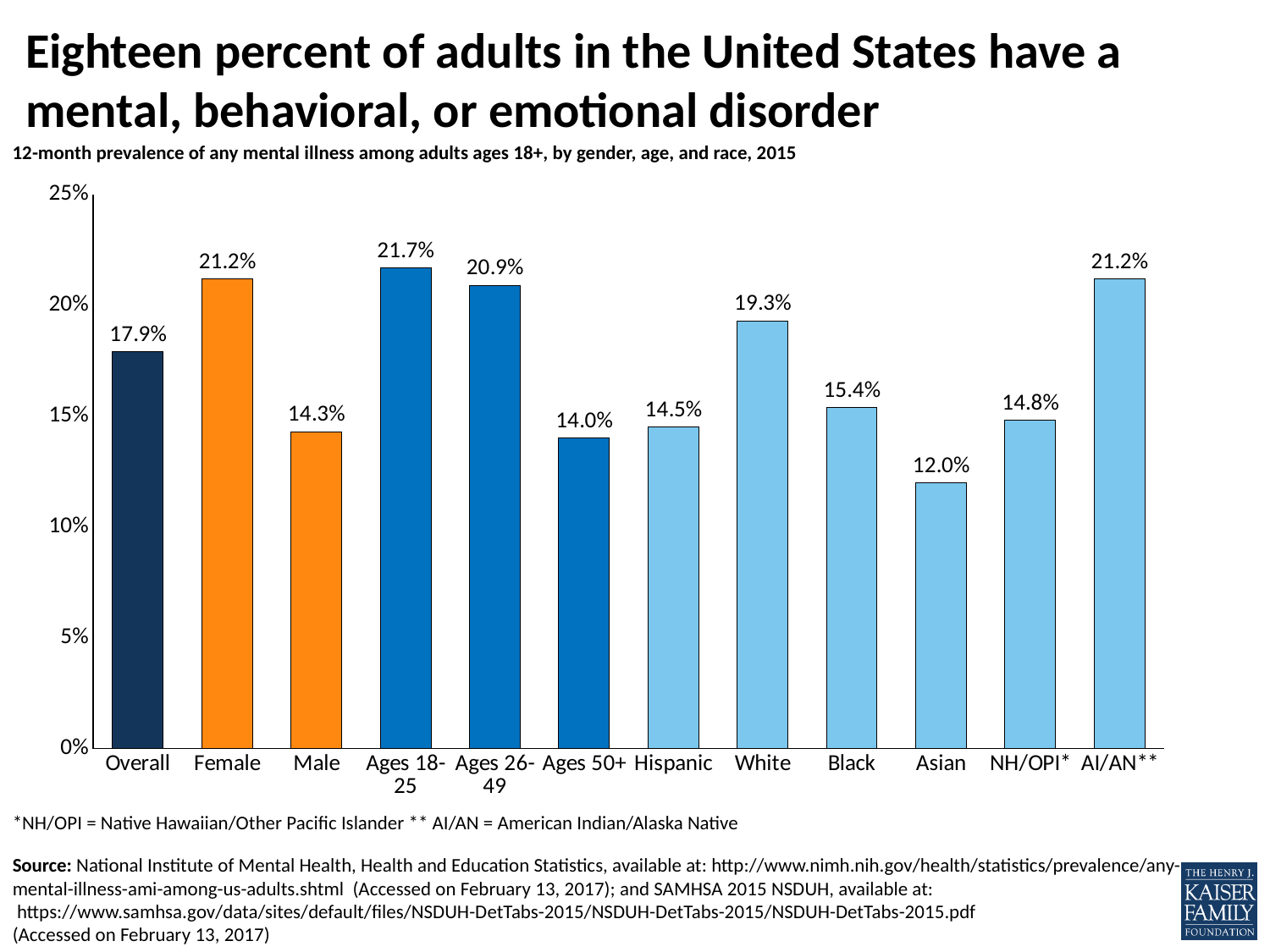
Is the value for Ages 50+ greater or less than 15%? less How many categories are shown on the x axis? 12 What is the value shown for the Overall category? 17.9% What is the difference between the White and Black values? 3.9% What is the difference between the Female and Male values? 6.9% What kind of chart is shown on the slide? bar chart What is the value shown for Asian adults? 12.0% Which category has the lowest prevalence of any mental illness? Asian Which is larger, the value for Hispanic or the value for Black? Black Which category has the highest prevalence of any mental illness? Ages 18-25 What does the abbreviation AI/AN stand for, according to the footnote? American Indian/Alaska Native What is the 12-month prevalence of any mental illness for Female adults? 21.2%